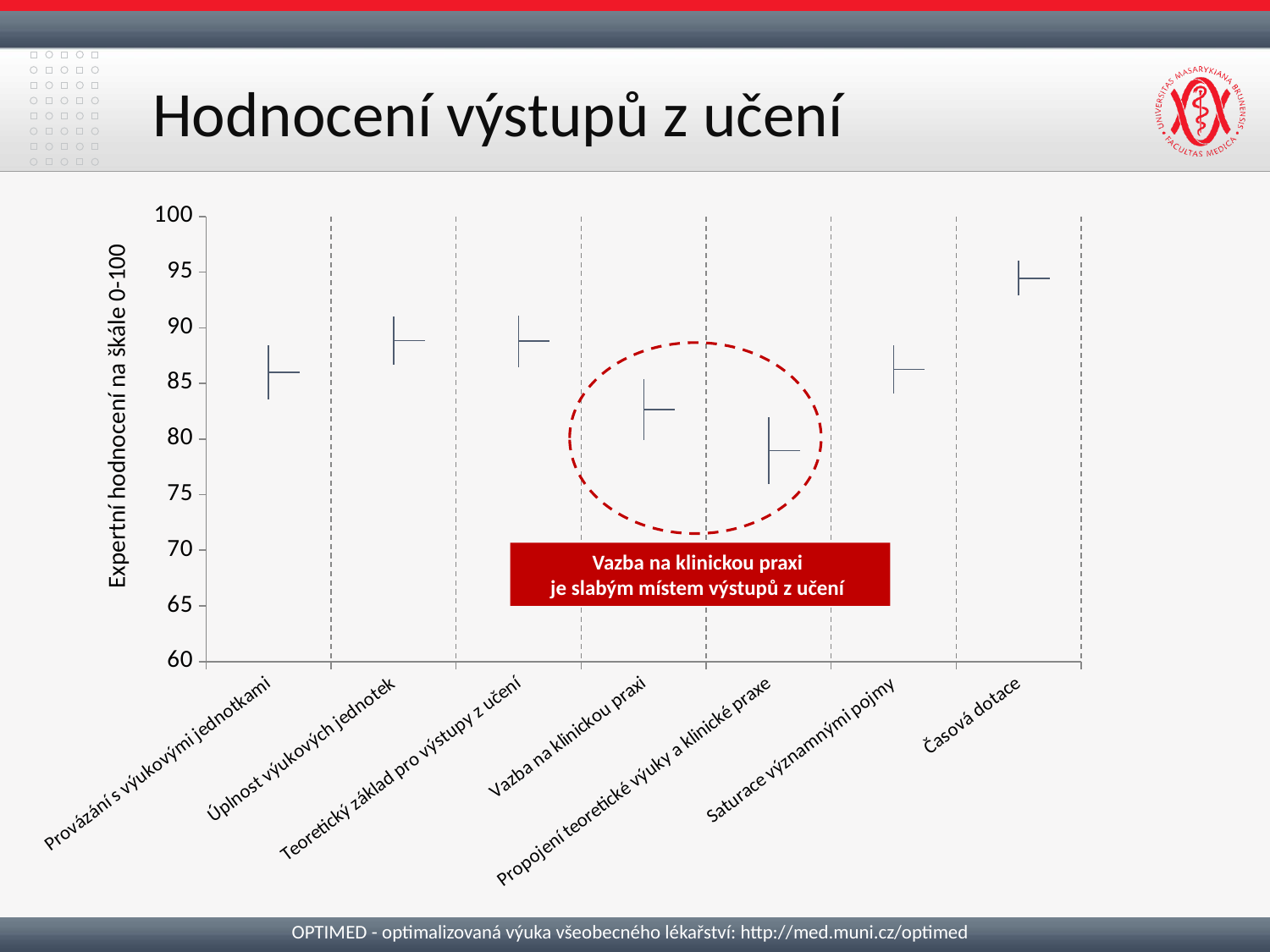
Which category has the lowest expert rating in the chart? Propojení teoretické výuky a klinické praxe Is the value for Vazba na klinickou praxi greater or less than 85? less Is the value for Úplnost výukových jednotek greater or less than 85? greater What is the title of the slide containing the chart? Hodnocení výstupů z učení Which has a higher value: Vazba na klinickou praxi or Propojení teoretické výuky a klinické praxe? Vazba na klinickou praxi Which category has the highest expert rating in the chart? Časová dotace Is the value for Časová dotace greater or less than 90? greater How many categories are plotted on the x axis of the chart? 7 Which has a higher value: Časová dotace or Provázání s výukovými jednotkami? Časová dotace What is the label of the y axis of the chart? Expertní hodnocení na škále 0-100